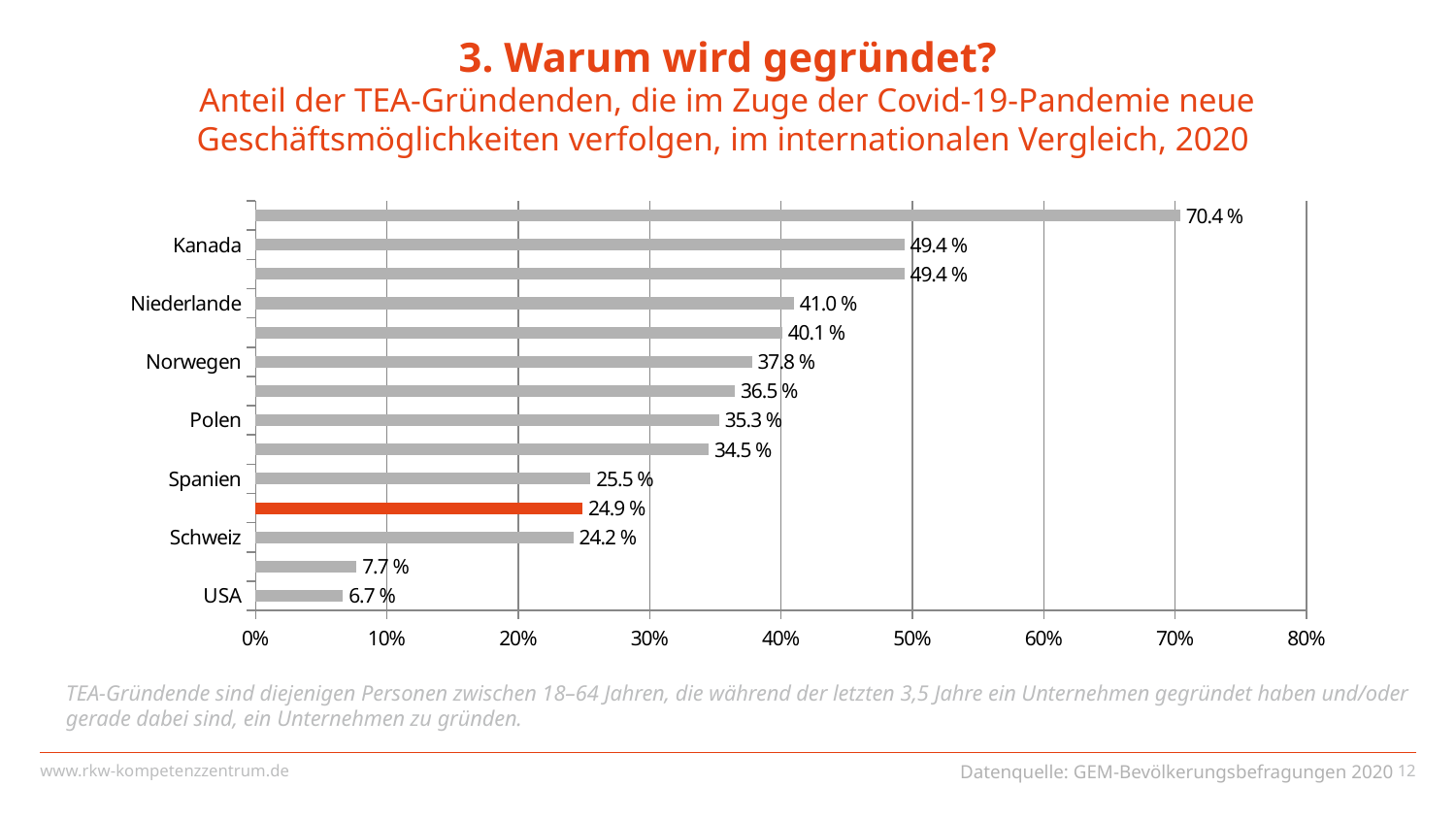
Is the value for Polen greater or less than 30%? greater How many bars are plotted on the chart? 14 Which labelled country has the lowest value? USA Which is larger, the value for Niederlande or the value for Norwegen? Niederlande What kind of chart is shown on the slide? bar chart What is the value for Niederlande? 41.0 % What is the difference between the values for Kanada and USA? 42.7 % What is the value for Kanada? 49.4 % What is the value for Schweiz? 24.2 % What is the value for USA? 6.7 % What is the value of the orange highlighted bar? 24.9 % What is the highest value shown on the chart? 70.4 %